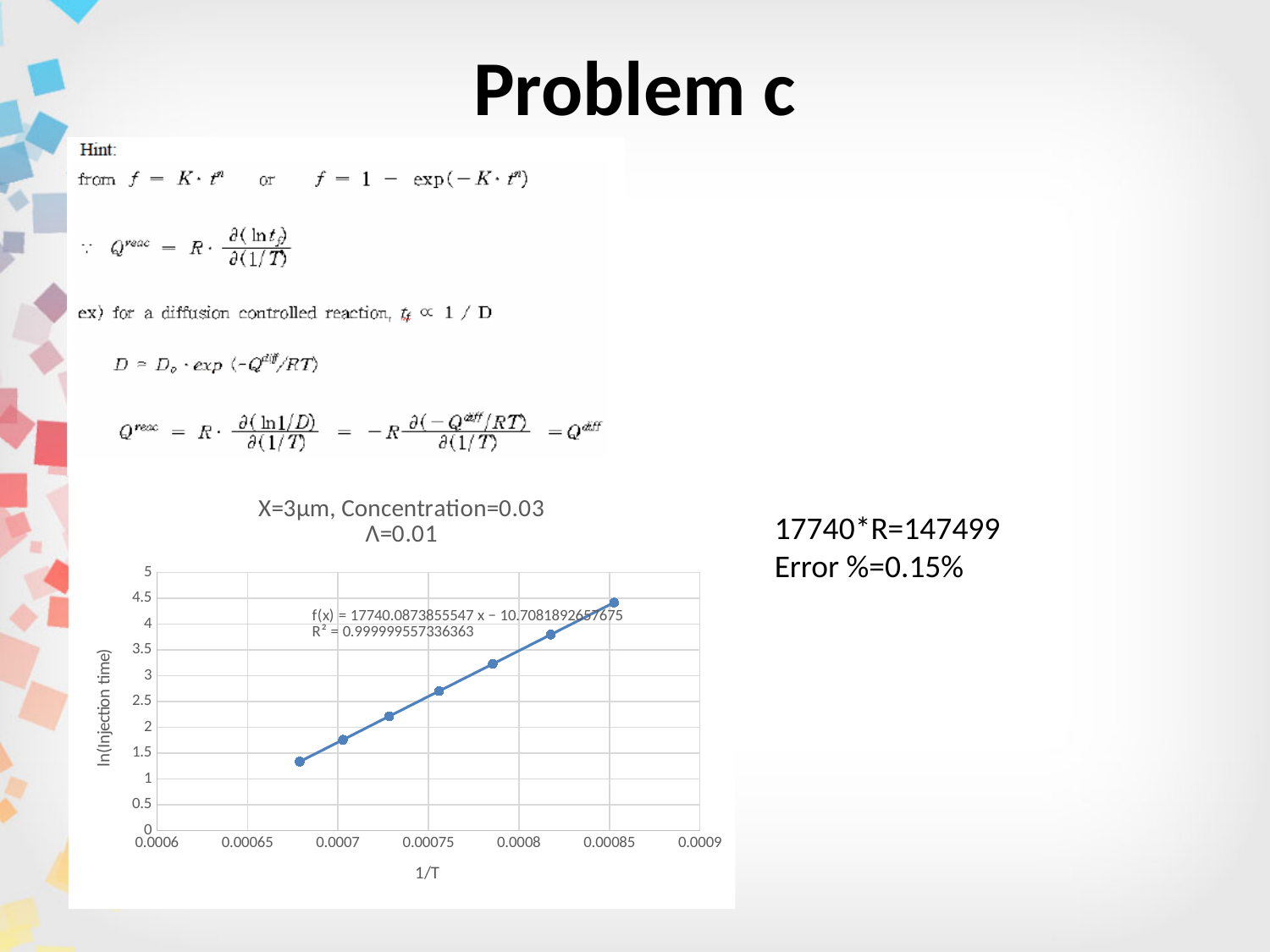
Is the ln(Injection time) value of the data point near 1/T = 0.00075 greater or less than 3? less What is the label of the vertical axis of the chart? ln(Injection time) What kind of chart is shown on the slide? scatter chart Which data point has the highest ln(Injection time), the one with the largest 1/T or the one with the smallest 1/T? the one with the largest 1/T What is the title of the chart? X=3μm, Concentration=0.03 Λ=0.01 What is the R² value printed on the chart? 0.999999557336363 Do the plotted values rise or fall as 1/T increases? rise How many data points are plotted on the chart? 7 Is the ln(Injection time) value of the leftmost data point greater or less than 1.5? less Is the ln(Injection time) value of the rightmost data point greater or less than 4? greater What is the intercept of the fitted line shown in the equation on the chart? −10.7081892657675 What is the slope of the fitted line shown in the equation on the chart? 17740.0873855547